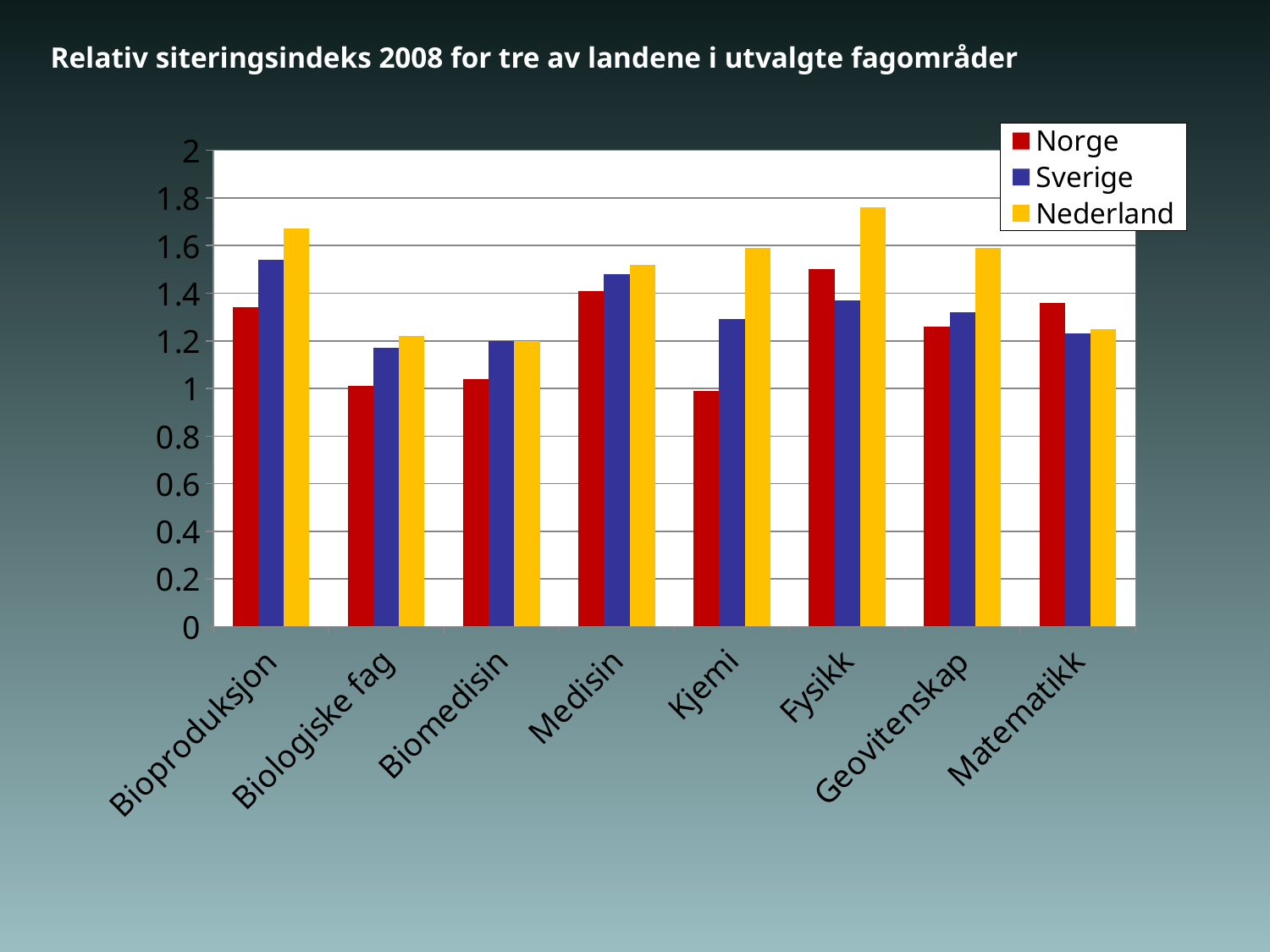
For Matematikk, which is larger: the value for Norge or for Nederland? Norge Is the value for Sverige in Bioproduksjon greater or less than 1.4? greater How many series does the legend list? 3 What kind of chart is shown on the slide? bar chart Which country has the highest value for Bioproduksjon? Nederland For Fysikk, which is larger: the value for Norge or for Sverige? Norge Is the value for Nederland in Kjemi greater or less than 1.4? greater What colour represents Nederland in the chart? yellow For Kjemi, which is larger: the value for Sverige or for Nederland? Nederland Which category has the highest value for Nederland? Fysikk Is the value for Norge in Kjemi greater or less than 1.2? less How many subject categories are shown on the x axis? 8